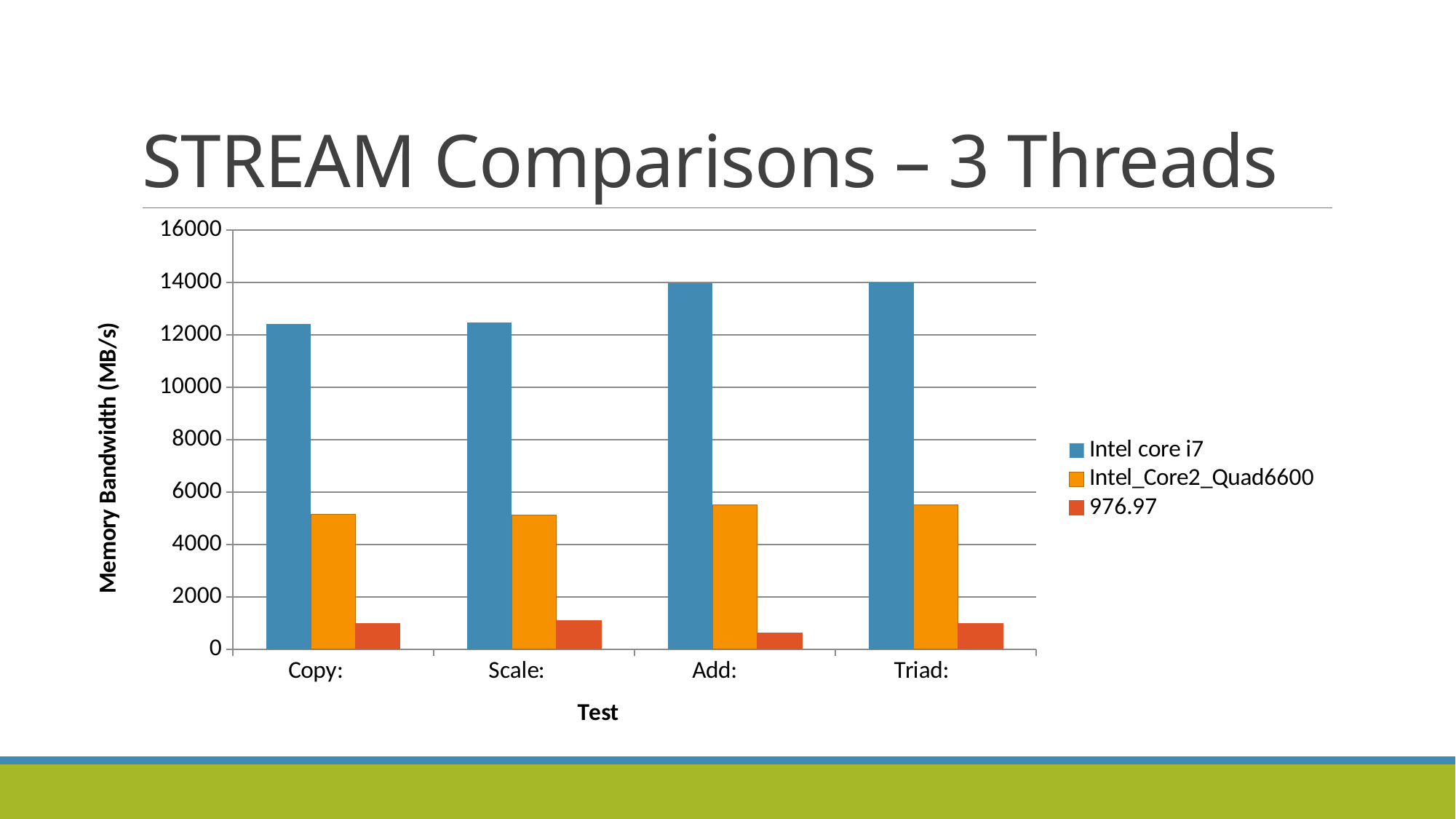
For the 976.97 series, which test has the lowest value? Add Is the value for Intel_Core2_Quad6600 on the Add test greater or less than 4000? greater Is the value for the 976.97 series on the Add test greater or less than 1000? less How many test categories are shown on the x axis? 4 How many series does the legend list? 3 Is the value for Intel_Core2_Quad6600 on the Copy test greater or less than 6000? less What kind of chart is shown on the slide? bar chart Which is larger on the Copy test: Intel core i7 or Intel_Core2_Quad6600? Intel core i7 Which colour represents Intel core i7 in the chart? blue What is the label of the y axis? Memory Bandwidth (MB/s)